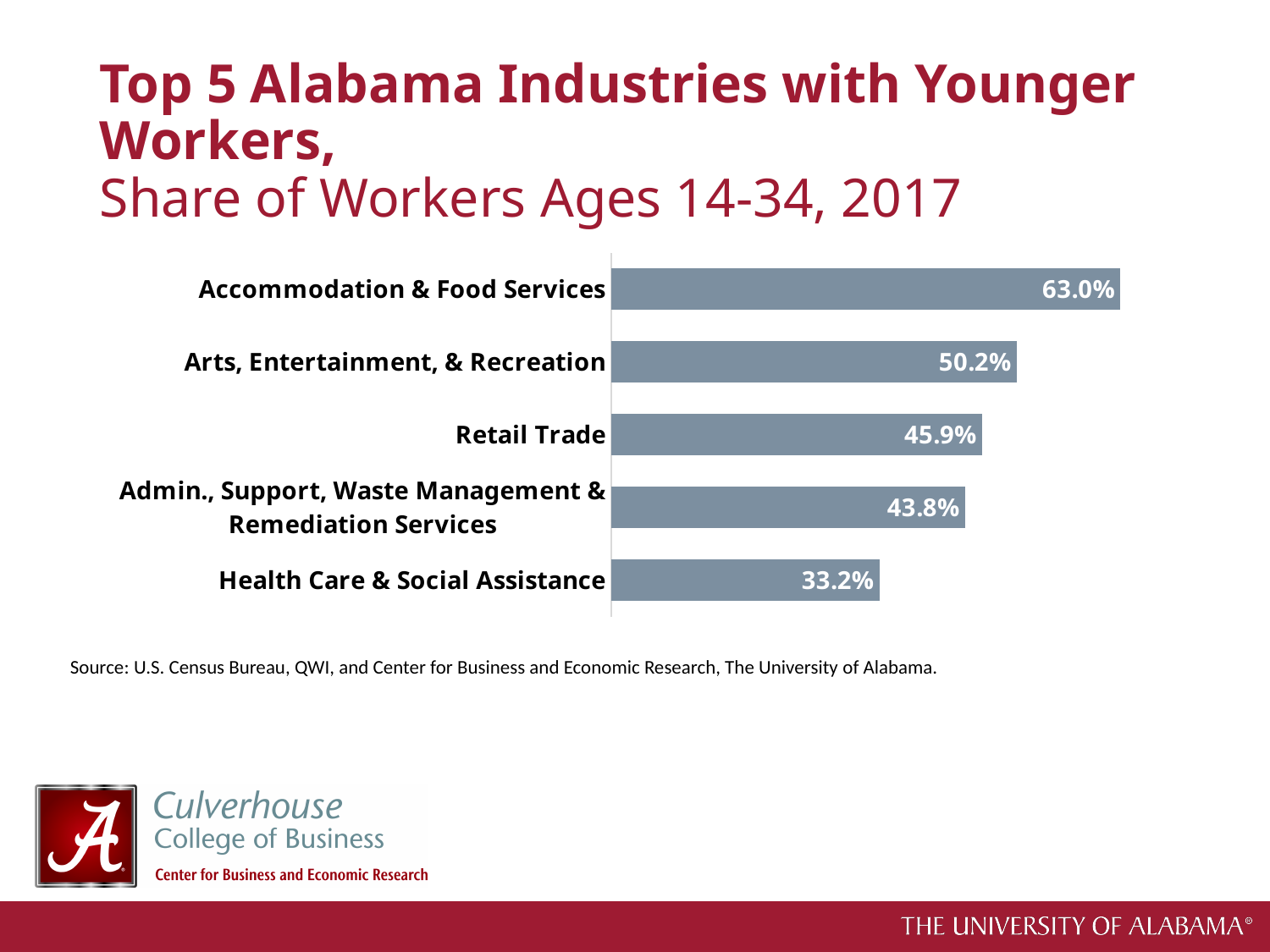
What year does the chart's data refer to? 2017 Which industry has the highest share of workers ages 14-34? Accommodation & Food Services What is the difference in percentage points between Retail Trade and Health Care & Social Assistance? 12.7 Which industry has the lowest share of workers ages 14-34? Health Care & Social Assistance How many industries are shown in the chart? 5 What is the difference in percentage points between Accommodation & Food Services and Arts, Entertainment, & Recreation? 12.8 What is the share of workers ages 14-34 in Retail Trade? 45.9% What is the share of workers ages 14-34 in Accommodation & Food Services? 63.0% Which has a larger share of younger workers, Arts, Entertainment, & Recreation or Retail Trade? Arts, Entertainment, & Recreation What is the share of workers ages 14-34 in Admin., Support, Waste Management & Remediation Services? 43.8% What type of chart is shown on the slide? Bar chart What is the share of workers ages 14-34 in Health Care & Social Assistance? 33.2%